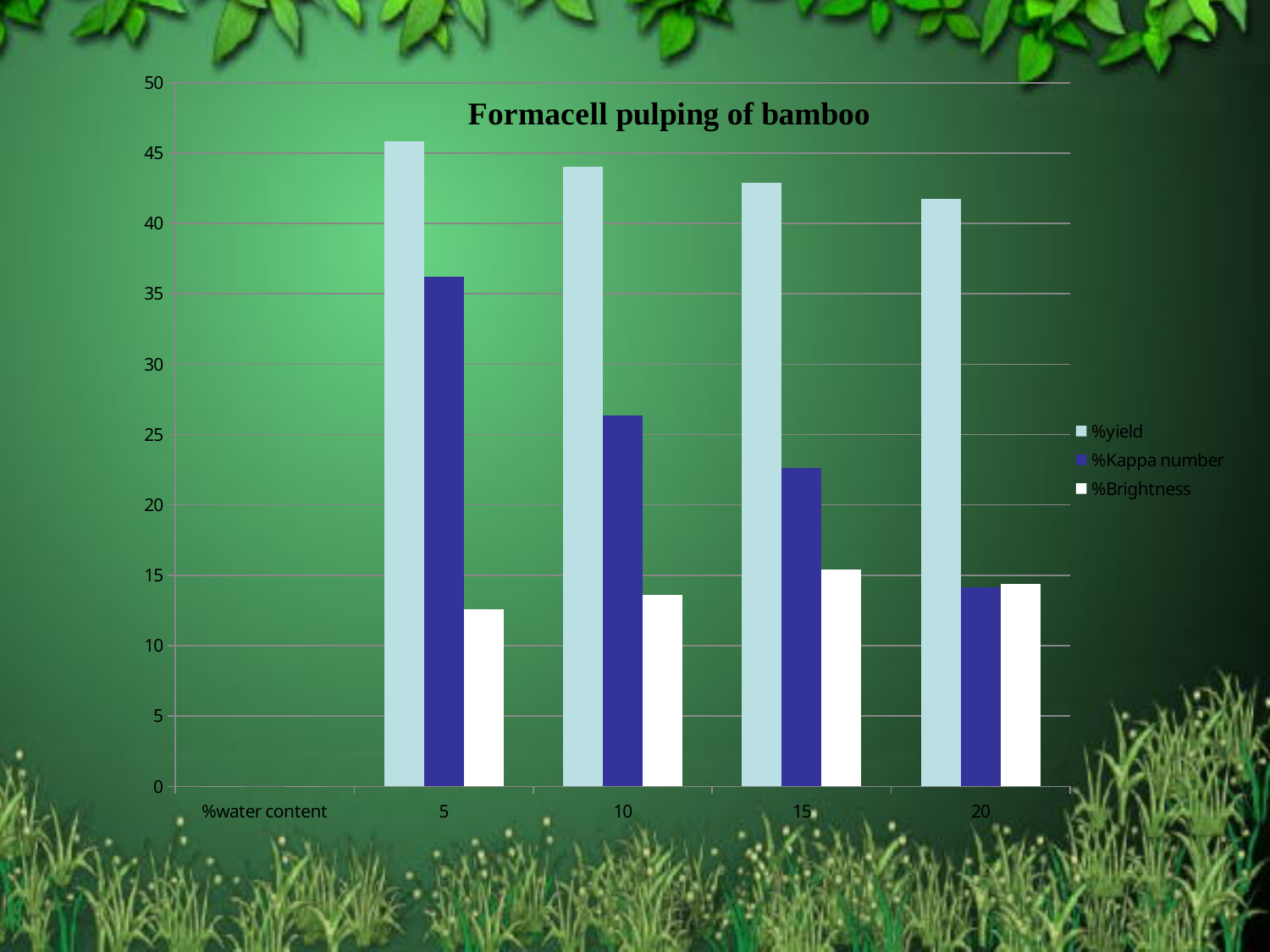
What is the title of the chart? Formacell pulping of bamboo Is the %yield value at 5 %water content greater or less than 40? greater At which %water content is %yield highest? 5 What kind of chart is shown on the slide? bar chart Is the %Kappa number value at 20 %water content greater or less than 15? less Does %Kappa number rise or fall as %water content increases from 5 to 20? fall How many groups of bars are plotted in the chart? 4 At 15 %water content, which is larger: %Kappa number or %Brightness? %Kappa number Is the %Brightness value at 5 %water content greater or less than 15? less At which %water content is %Kappa number lowest? 20 How many series does the legend list? 3